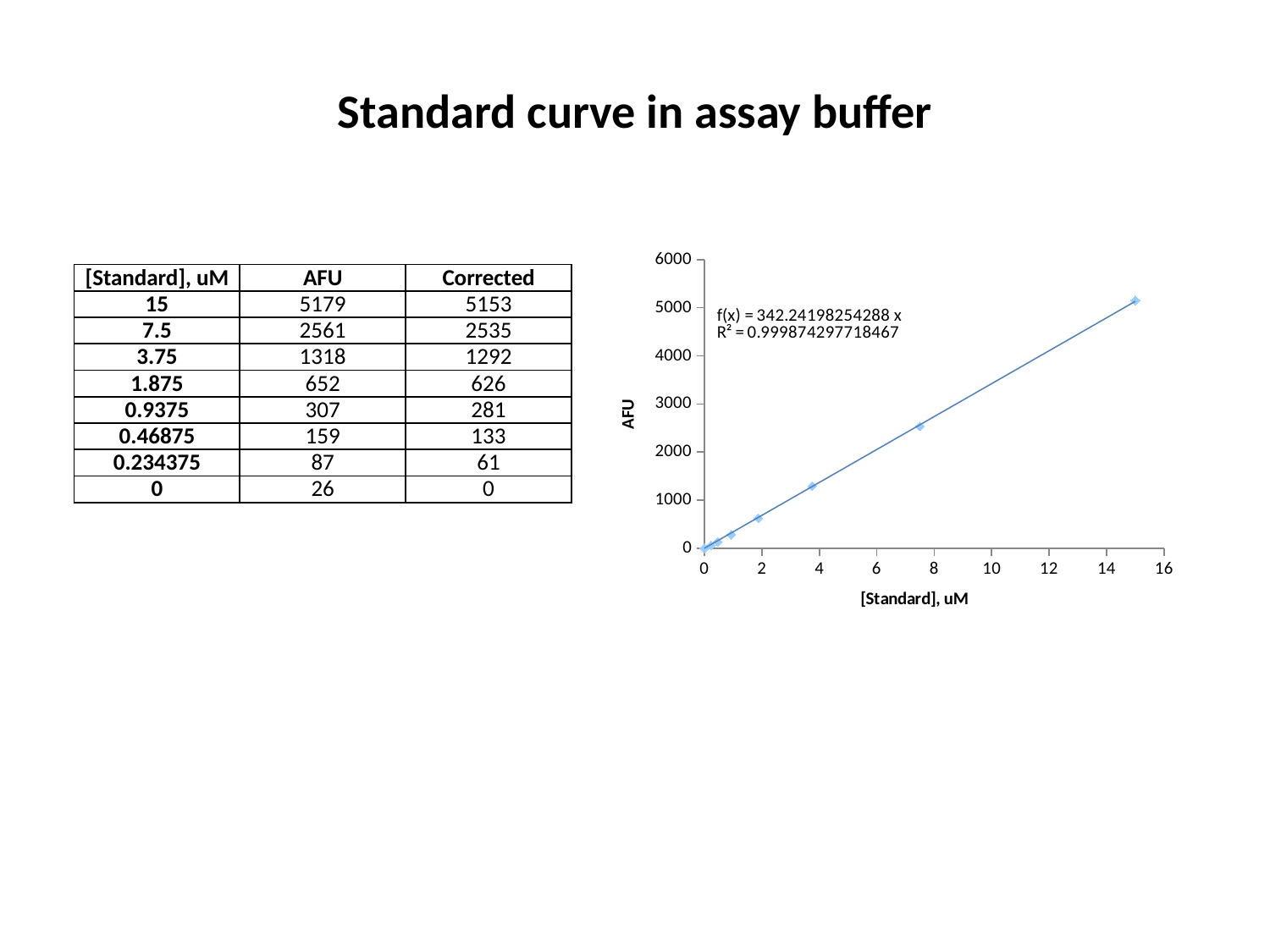
Is the AFU value at 7.5 uM greater or less than 2000? greater What is the R² value shown on the chart? 0.999874297718467 What kind of chart is shown on the slide? Scatter chart with a linear trendline Which plotted point has the highest AFU value, the one at 15 uM or the one at 7.5 uM? 15 uM Is the AFU value at 15 uM greater or less than 5000? greater Is the AFU value at 3.75 uM greater or less than 1000? greater What is the title of the x axis of the chart? [Standard], uM Do the AFU values rise or fall as [Standard], uM increases along the x axis? Rise